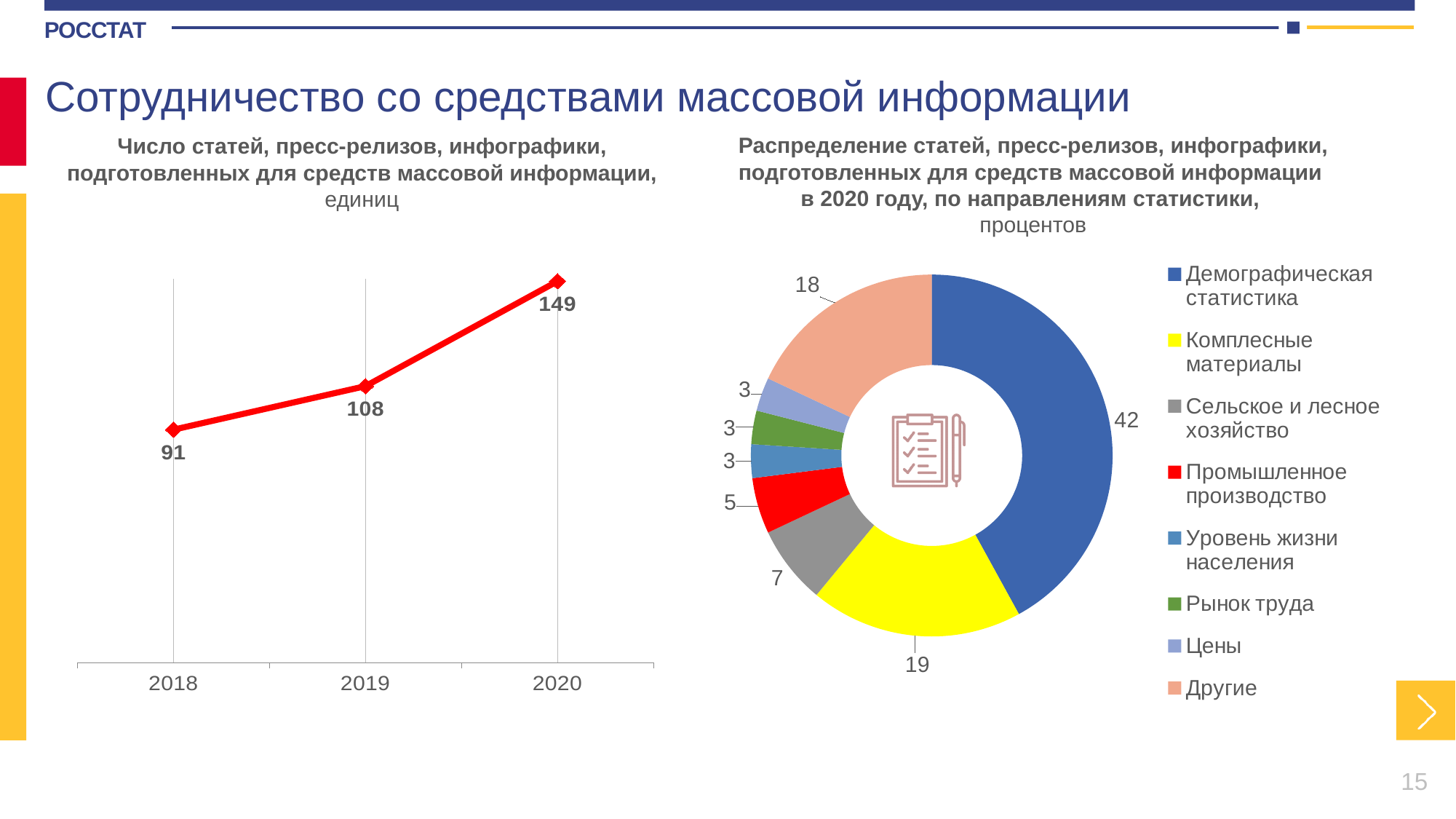
In the left chart (Число статей, пресс-релизов, инфографики), what is the value for 2019? 108 How many categories does the legend of the right chart (Распределение статей ... в 2020 году) list? 8 In the left chart (Число статей, пресс-релизов, инфографики), what is the difference between the 2020 and 2018 values? 58 In the right chart (Распределение статей ... в 2020 году), which category has the largest share? Демографическая статистика In the right chart (Распределение статей ... в 2020 году), which is larger: Сельское и лесное хозяйство or Промышленное производство? Сельское и лесное хозяйство In the left chart (Число статей, пресс-релизов, инфографики), which year has the lowest value? 2018 In the left chart (Число статей, пресс-релизов, инфографики), do the values rise or fall from 2018 to 2020? rise In the right chart (Распределение статей ... в 2020 году), what is the value for Демографическая статистика? 42 What kind of chart is the left chart (Число статей, пресс-релизов, инфографики)? line chart In the right chart (Распределение статей ... в 2020 году), what is the value for Комплесные материалы? 19 In the left chart (Число статей, пресс-релизов, инфографики), what is the value for 2020? 149 How many years are plotted in the left chart (Число статей, пресс-релизов, инфографики)? 3